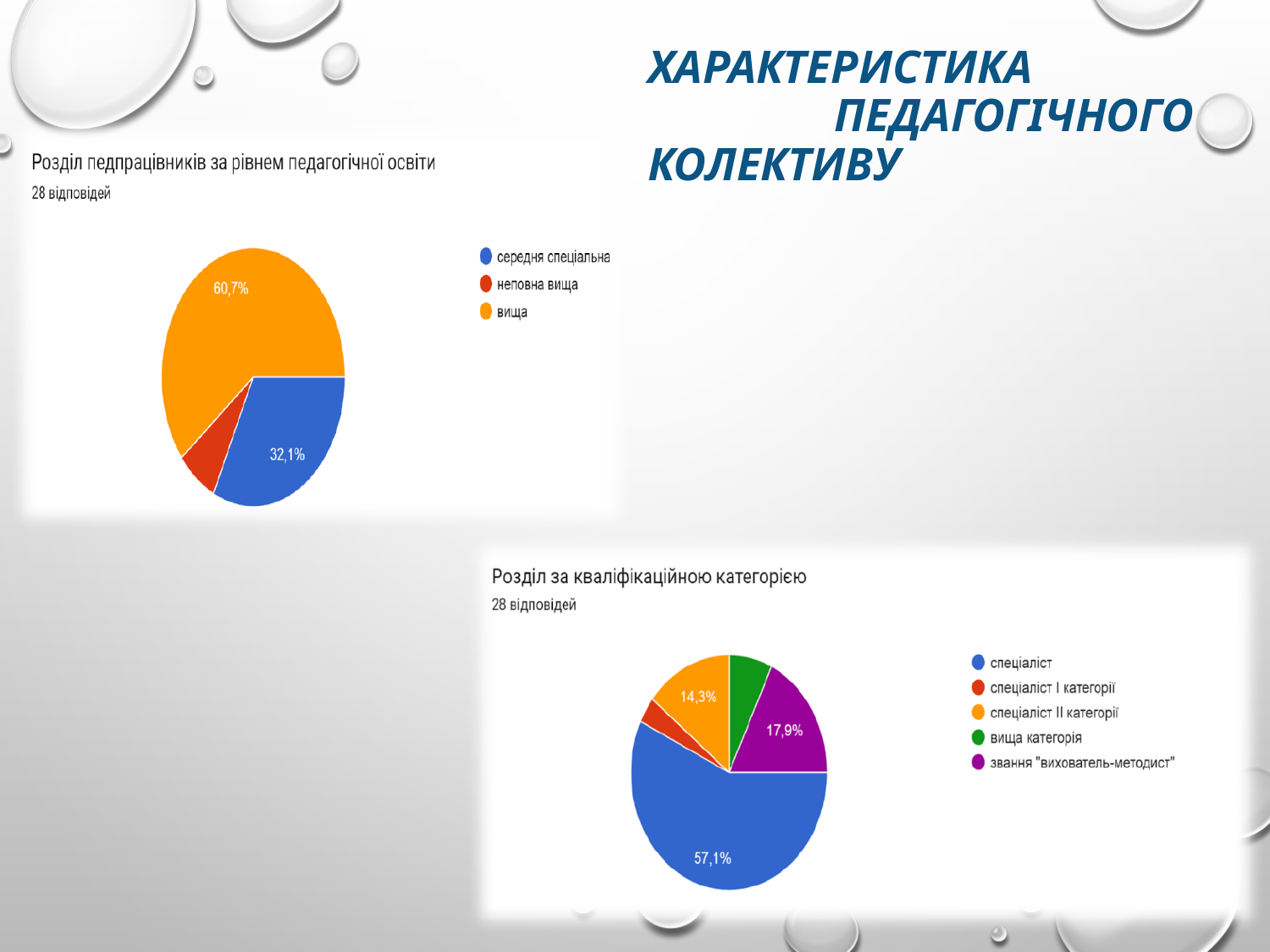
In the chart titled "Розділ педпрацівників за рівнем педагогічної освіти", which category has the smallest slice? неповна вища How many categories does the legend of the chart titled "Розділ педпрацівників за рівнем педагогічної освіти" list? 3 In the chart titled "Розділ педпрацівників за рівнем педагогічної освіти", which category has the largest slice? вища In the chart titled "Розділ педпрацівників за рівнем педагогічної освіти", what is the difference in percentage points between "вища" and "середня спеціальна"? 28,6 In the chart titled "Розділ за кваліфікаційною категорією", which category has the largest slice? спеціаліст In the chart titled "Розділ педпрацівників за рівнем педагогічної освіти", what share of the pie is "вища"? 60,7% In the chart titled "Розділ за кваліфікаційною категорією", what share of the pie is "звання "вихователь-методист""? 17,9% What type of chart is the chart titled "Розділ за кваліфікаційною категорією"? pie chart In the chart titled "Розділ за кваліфікаційною категорією", which is larger: "звання "вихователь-методист"" or "спеціаліст II категорії"? звання "вихователь-методист" In the chart titled "Розділ педпрацівників за рівнем педагогічної освіти", what share of the pie is "середня спеціальна"? 32,1% In the chart titled "Розділ за кваліфікаційною категорією", what share of the pie is "спеціаліст II категорії"? 14,3% In the chart titled "Розділ за кваліфікаційною категорією", what share of the pie is "спеціаліст"? 57,1%